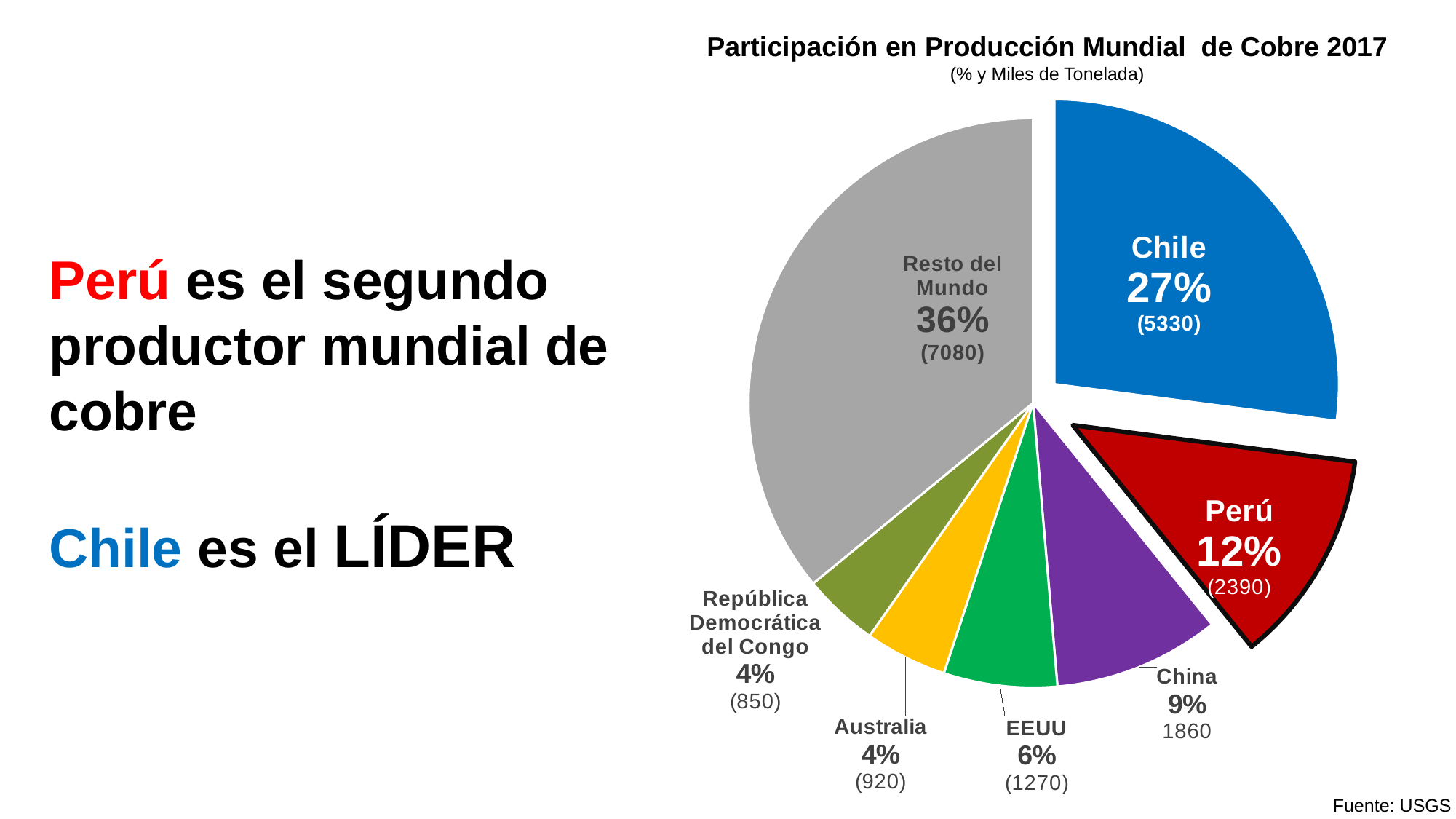
What colour is the Perú slice? red Which has a larger share, China or EEUU? China Which country has the largest share among the named countries? Chile What share of world copper production does Perú have? 12% What is the production value in thousands of tonnes for EEUU? 1270 Which slice of the pie is the largest? Resto del Mundo What type of chart is shown on the slide? pie chart How many slices does the pie chart have? 7 What is the production value in thousands of tonnes for China? 1860 What is the difference in production between Chile and Perú, in thousands of tonnes? 2940 What share of world copper production does Chile have? 27% What is the title of the chart? Participación en Producción Mundial de Cobre 2017